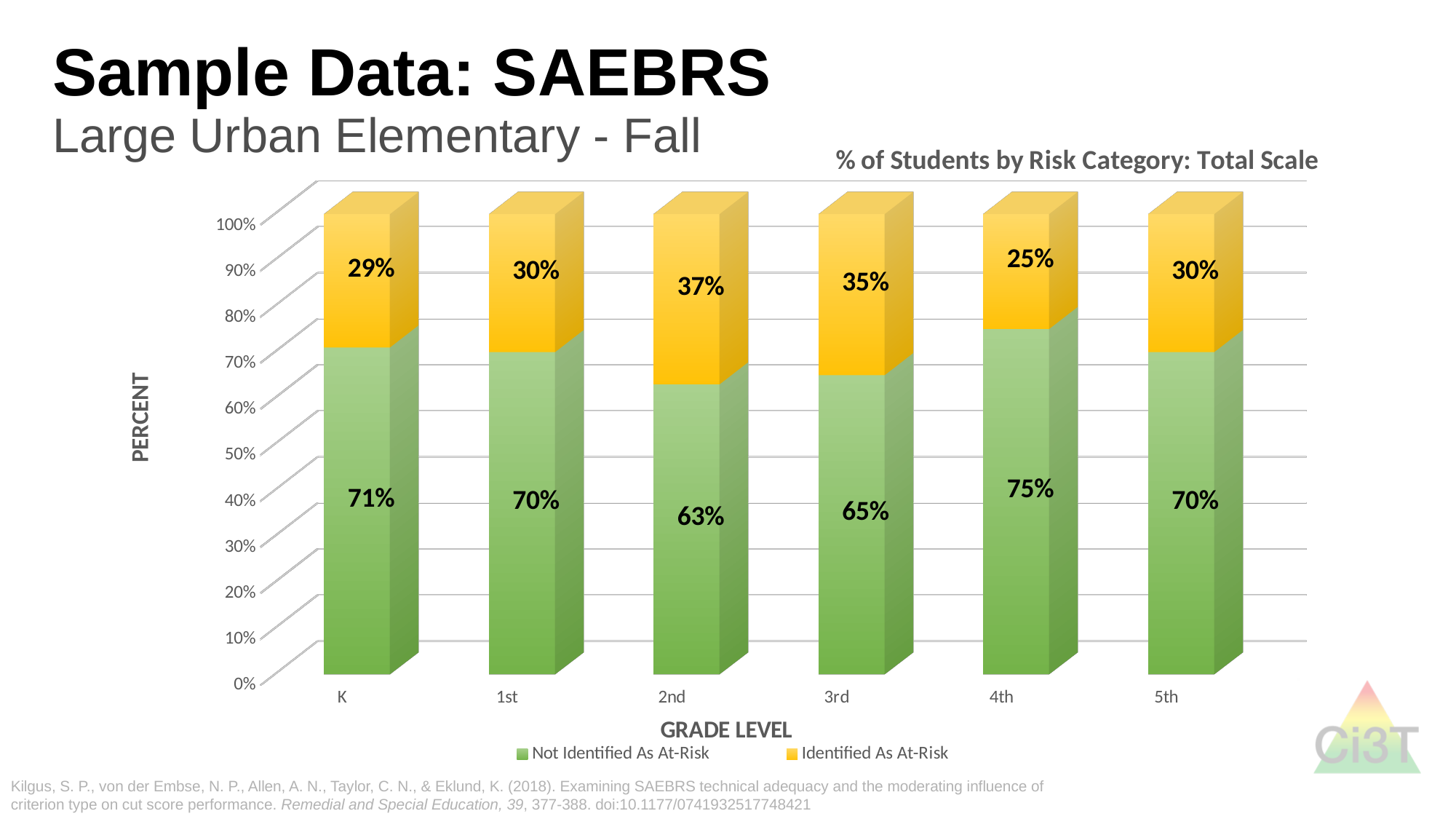
What is the total of the stacked bar for 1st grade? 100% Which grade level has the lowest percentage of students Identified As At-Risk? 4th What kind of chart is shown on the slide? Stacked bar chart How many grade levels are shown on the x axis? 6 What is the difference between the Not Identified As At-Risk percentages for 4th grade and 2nd grade? 12% How many series does the legend list? 2 What is the title of the chart? % of Students by Risk Category: Total Scale Which is larger: the Identified As At-Risk percentage for 3rd grade or for 5th grade? 3rd grade Which grade level has the highest percentage of students Identified As At-Risk? 2nd What percentage of 4th grade students were Not Identified As At-Risk? 75% What percentage of K students were Identified As At-Risk? 29% What percentage of 2nd grade students were Identified As At-Risk? 37%